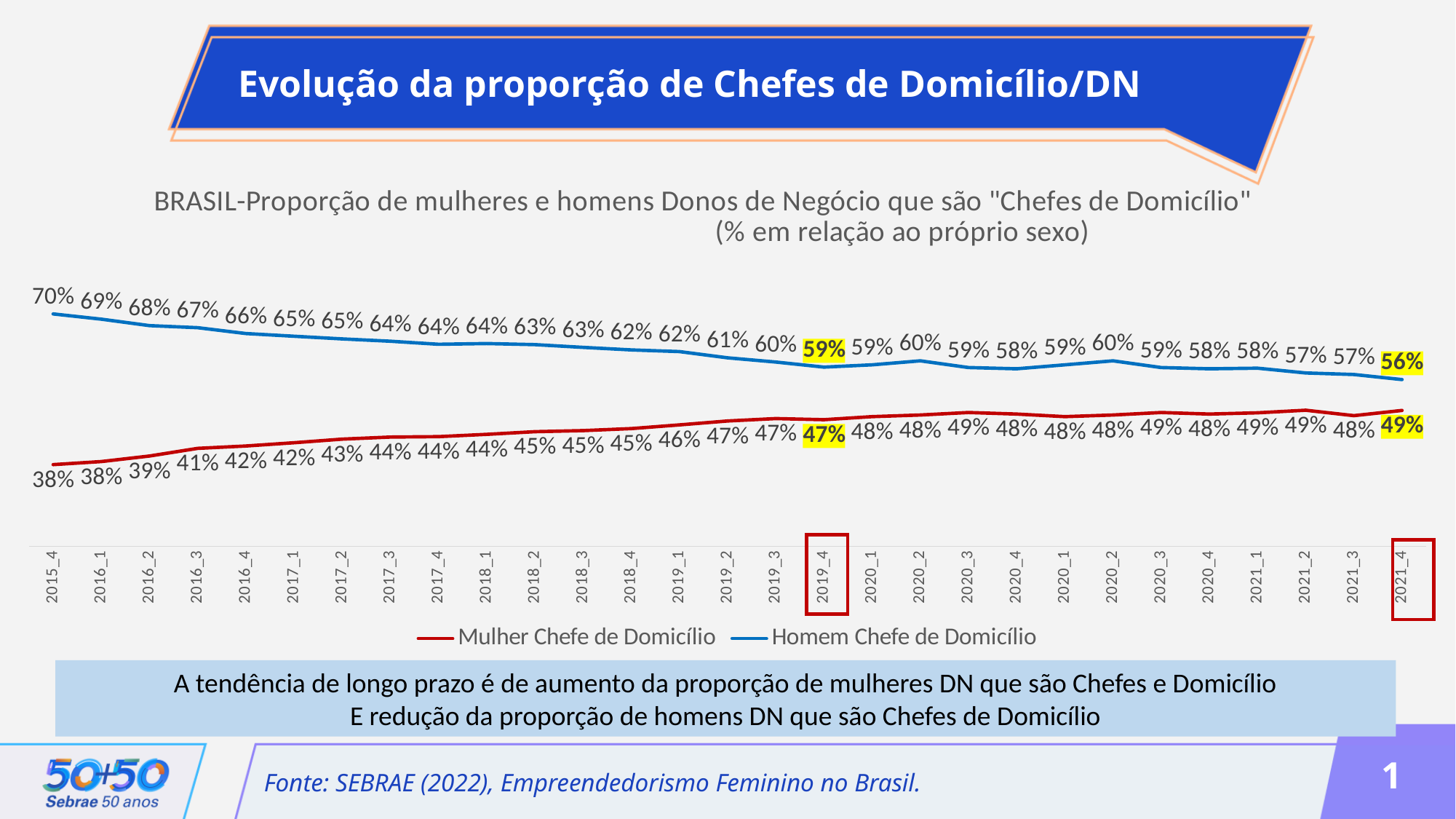
What is the value for Homem Chefe de Domicílio in 2021_4? 56% What kind of chart is shown on the slide? Line chart What colour is the Mulher Chefe de Domicílio line? Red What is the difference between the Homem and Mulher values in 2015_4? 32 percentage points How many series does the legend list? 2 What is the value for Homem Chefe de Domicílio in 2015_4? 70% What is the value for Mulher Chefe de Domicílio in 2021_4? 49% What is the difference between the Homem and Mulher values in 2021_4? 7 percentage points What is the highlighted value for Mulher Chefe de Domicílio in 2019_4? 47% Does the Homem Chefe de Domicílio line rise or fall from 2015_4 to 2021_4? Fall What is the value for Mulher Chefe de Domicílio in 2015_4? 38% What is the highlighted value for Homem Chefe de Domicílio in 2019_4? 59%